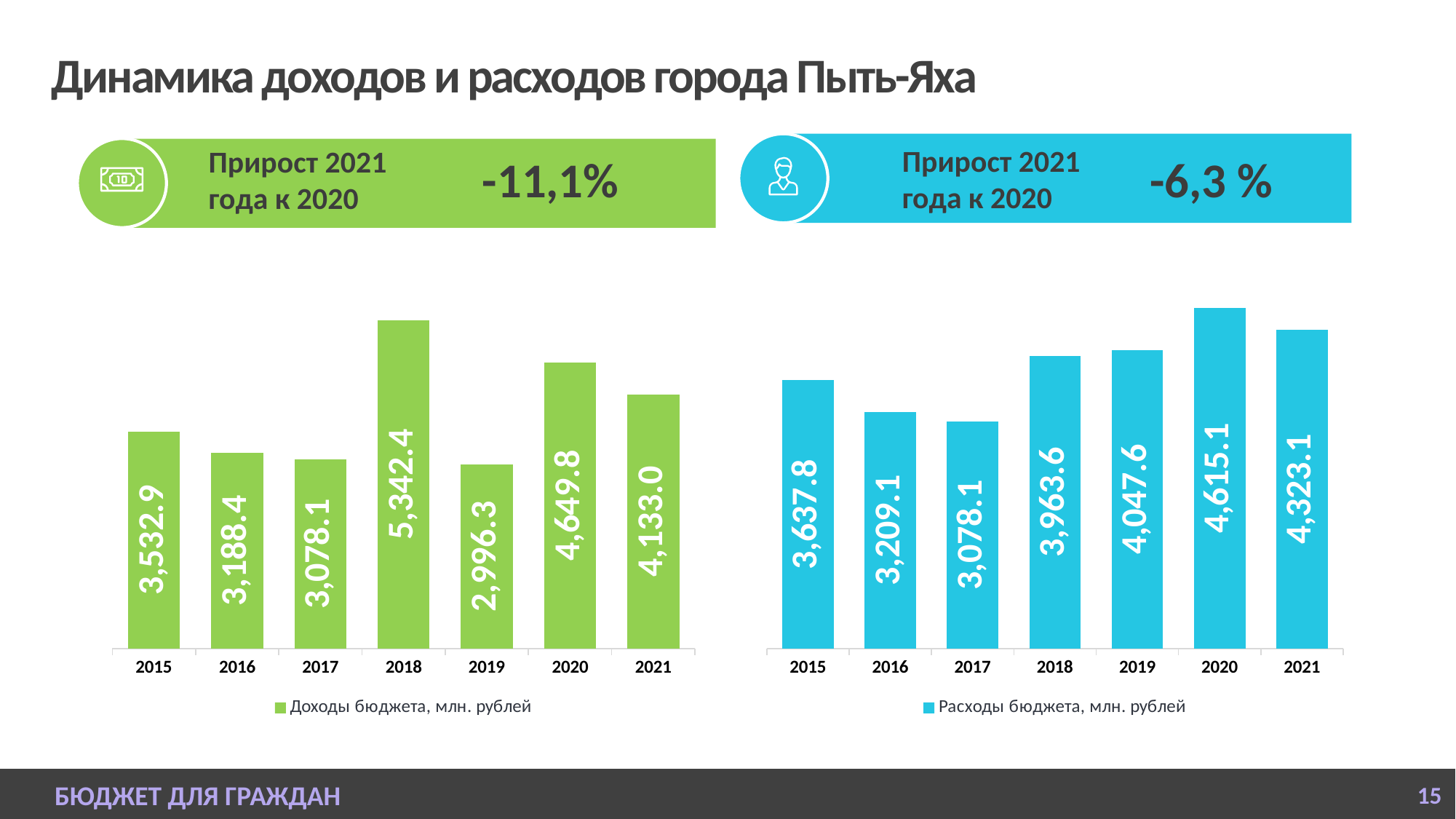
In the right chart (Расходы бюджета, млн. рублей), which year has the lowest value? 2017 What type of chart is the left chart (Доходы бюджета, млн. рублей)? Bar chart In the left chart (Доходы бюджета, млн. рублей), which is larger: the value for 2015 or the value for 2016? 2015 In the left chart (Доходы бюджета, млн. рублей), what is the value for 2018? 5,342.4 In the right chart (Расходы бюджета, млн. рублей), which year has the highest value? 2020 In the right chart (Расходы бюджета, млн. рублей), do the values rise or fall from 2017 to 2020? Rise In the left chart (Доходы бюджета, млн. рублей), which year has the lowest value? 2019 In the right chart (Расходы бюджета, млн. рублей), what is the difference between the values for 2020 and 2021? 292.0 In the left chart (Доходы бюджета, млн. рублей), what is the difference between the values for 2020 and 2021? 516.8 How many years are shown on the x axis of the right chart (Расходы бюджета, млн. рублей)? 7 In the right chart (Расходы бюджета, млн. рублей), what is the value for 2019? 4,047.6 What is the legend entry of the right chart? Расходы бюджета, млн. рублей